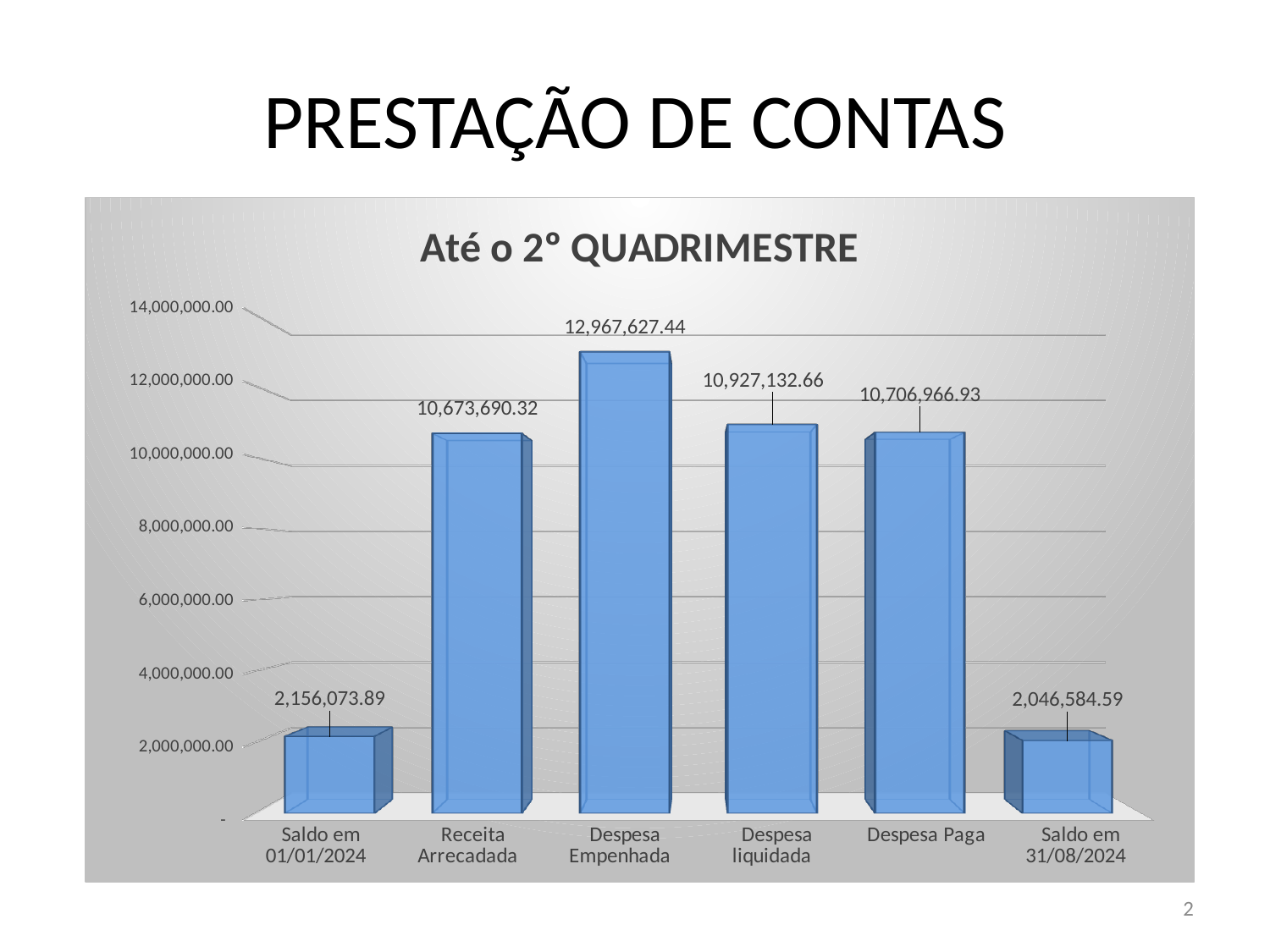
Which category has the lowest value? Saldo em 31/08/2024 How many categories are shown on the x axis? 6 What is the value for Despesa Empenhada? 12,967,627.44 Which is larger, Despesa liquidada or Despesa Paga? Despesa liquidada What is the title of the chart? Até o 2º QUADRIMESTRE Is the value for Despesa Empenhada greater or less than 12,000,000.00? greater What is the value for Saldo em 31/08/2024? 2,046,584.59 What is the value for Despesa Paga? 10,706,966.93 What is the value for Receita Arrecadada? 10,673,690.32 What is the difference between Despesa Empenhada and Despesa liquidada? 2,040,494.78 What is the difference between Saldo em 01/01/2024 and Saldo em 31/08/2024? 109,489.30 Which category has the highest value? Despesa Empenhada